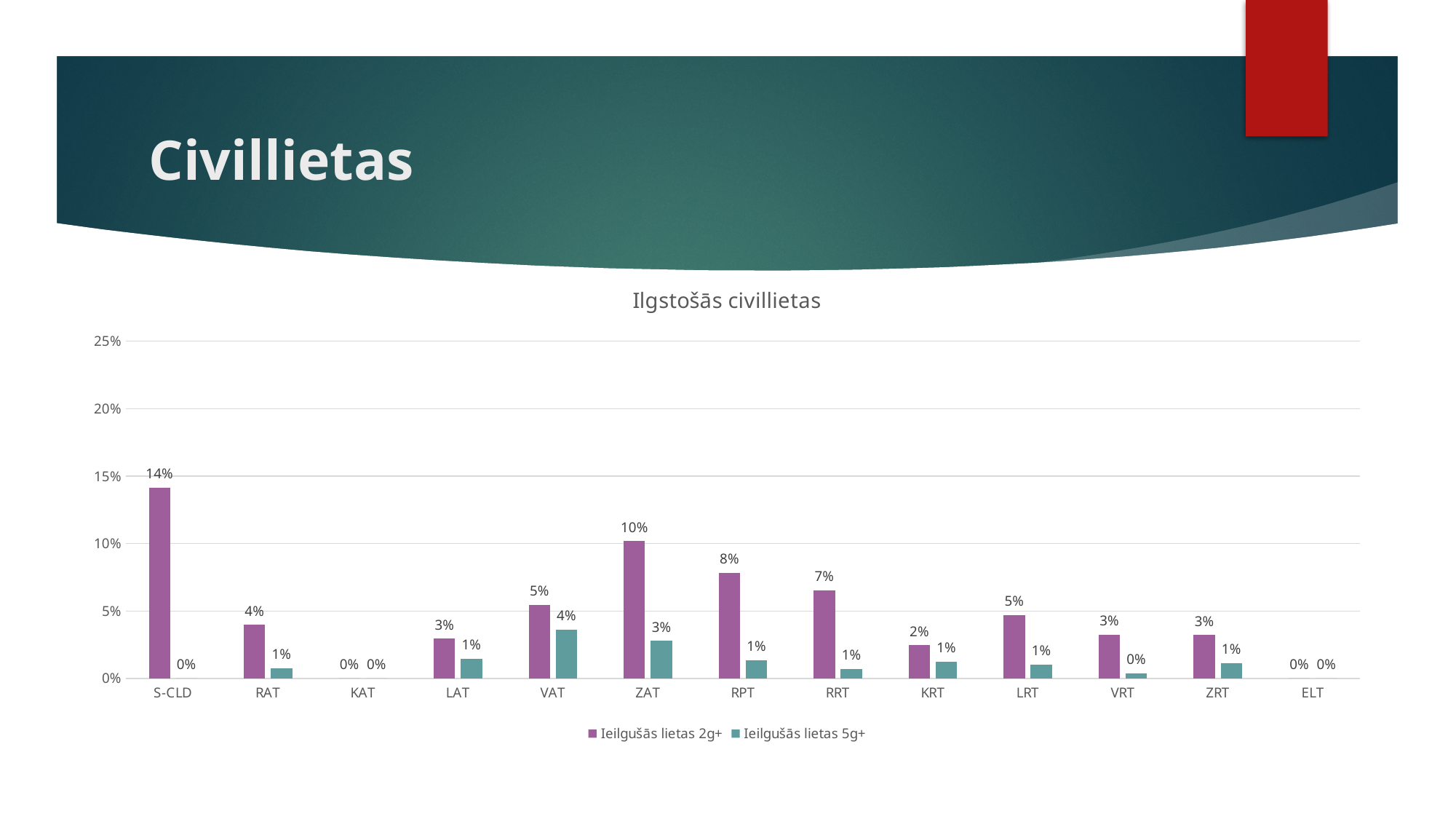
What is the difference between the Ieilgušās lietas 2g+ values for S-CLD and ZAT? 4% What type of chart is shown on the slide? bar chart What is the value of Ieilgušās lietas 2g+ for S-CLD? 14% How many categories are shown on the x axis? 13 What is the title of the chart? Ilgstošās civillietas How many series does the legend list? 2 Which category has the highest value for Ieilgušās lietas 2g+? S-CLD What is the value of Ieilgušās lietas 2g+ for ZAT? 10% What is the value of Ieilgušās lietas 5g+ for VAT? 4% Which category has the highest value for Ieilgušās lietas 5g+? VAT Which is larger, the Ieilgušās lietas 2g+ value for RPT or for RRT? RPT Is the Ieilgušās lietas 2g+ value for S-CLD greater or less than 10%? greater